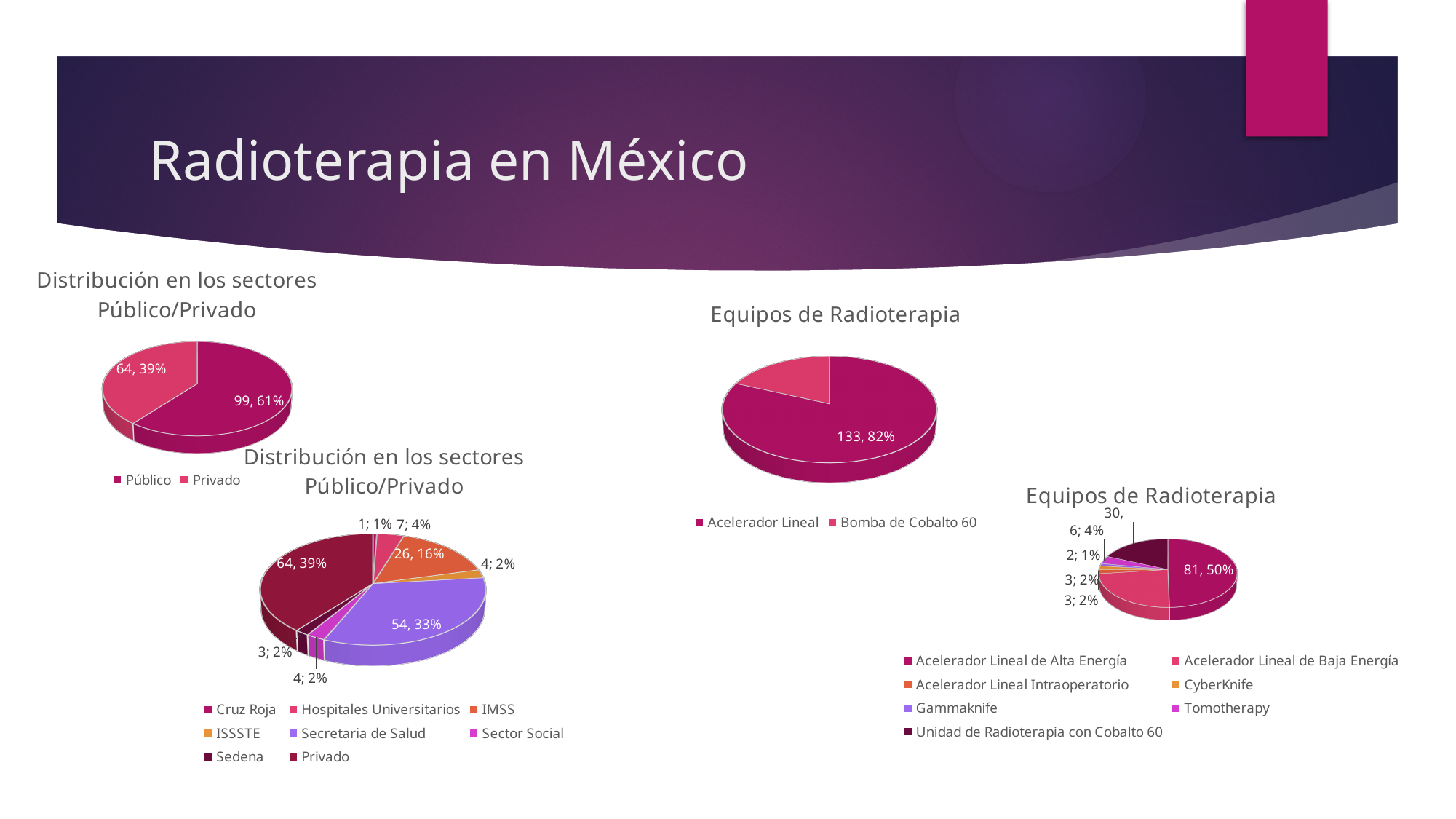
In the top-left chart 'Distribución en los sectores Público/Privado', which sector is larger, Público or Privado? Público In the top-left chart 'Distribución en los sectores Público/Privado', what is the value shown for Público? 99, 61% In the bottom-right detailed chart 'Equipos de Radioterapia', what is the value shown for Acelerador Lineal de Alta Energía? 81, 50% In the bottom-left detailed chart 'Distribución en los sectores Público/Privado', which category has the largest slice? Privado In the top-left chart 'Distribución en los sectores Público/Privado', what is the difference between the Público count and the Privado count? 35 What kind of chart is the top-right 'Equipos de Radioterapia' chart? Pie chart In the bottom-left detailed chart 'Distribución en los sectores Público/Privado', what is the value shown for IMSS? 26, 16% In the bottom-left detailed chart 'Distribución en los sectores Público/Privado', what is the value shown for Secretaria de Salud? 54, 33% In the top-right chart 'Equipos de Radioterapia', what is the value shown for Acelerador Lineal? 133, 82% In the top-left chart 'Distribución en los sectores Público/Privado', what is the value shown for Privado? 64, 39% In the bottom-left detailed chart 'Distribución en los sectores Público/Privado', which category has the smallest slice? Cruz Roja How many categories does the legend of the bottom-left detailed chart 'Distribución en los sectores Público/Privado' list? 8